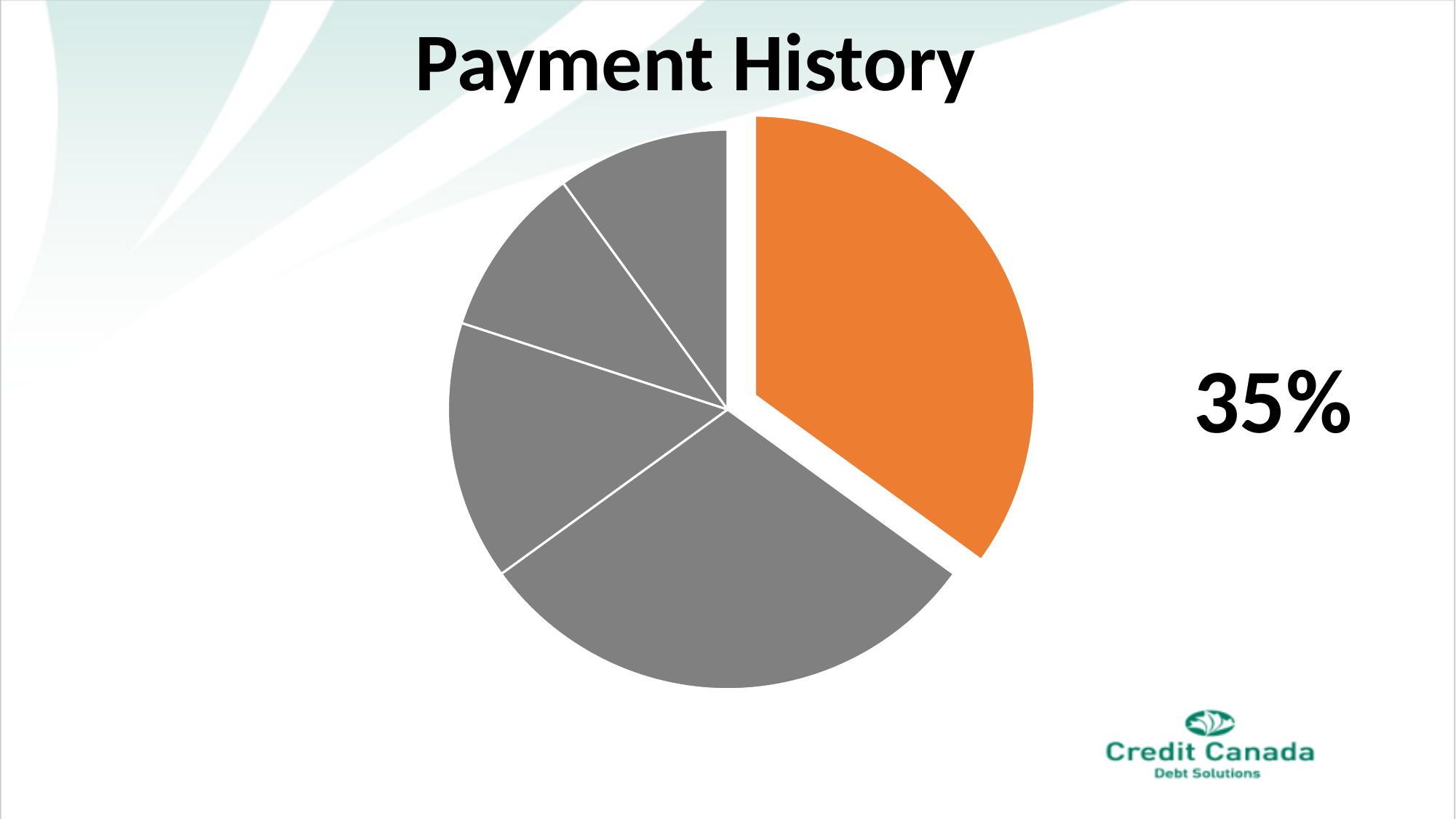
Is the orange slice larger or smaller than the grey slice on the upper left of the pie? larger What is the title of the chart? Payment History Which is larger: the orange slice or the small grey slice at the top of the pie? the orange slice What colour is the slice that is pulled out from the rest of the pie? orange What kind of chart is shown on the slide? pie chart How many slices does the pie chart have in total? 5 How many grey slices are in the pie chart? 4 What share of the pie does the highlighted (orange) slice represent? 35% What percentage is shown for the orange slice of the pie? 35%